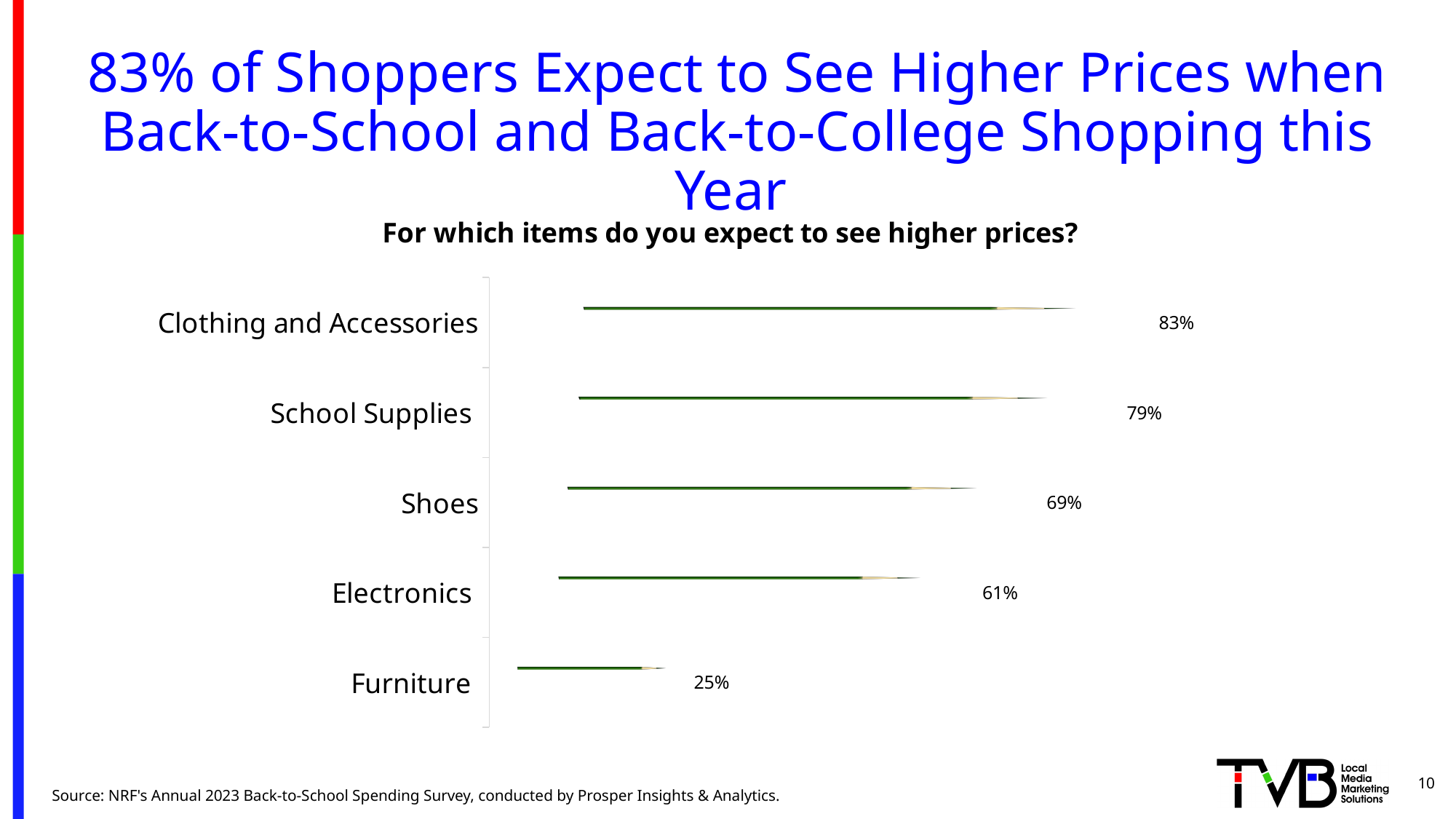
What percentage of shoppers expect to see higher prices for Electronics? 61% Which has a higher value, School Supplies or Shoes? School Supplies What percentage of shoppers expect to see higher prices for School Supplies? 79% What percentage of shoppers expect to see higher prices for Clothing and Accessories? 83% What is the difference in percentage points between Clothing and Accessories and Furniture? 58 Which item has the highest percentage of shoppers expecting higher prices? Clothing and Accessories What kind of chart is shown on the slide? Bar chart What is the difference in percentage points between Shoes and Electronics? 8 Which item has the lowest percentage of shoppers expecting higher prices? Furniture How many items are shown in the chart? 5 What percentage of shoppers expect to see higher prices for Furniture? 25% What question does the chart title ask? For which items do you expect to see higher prices?